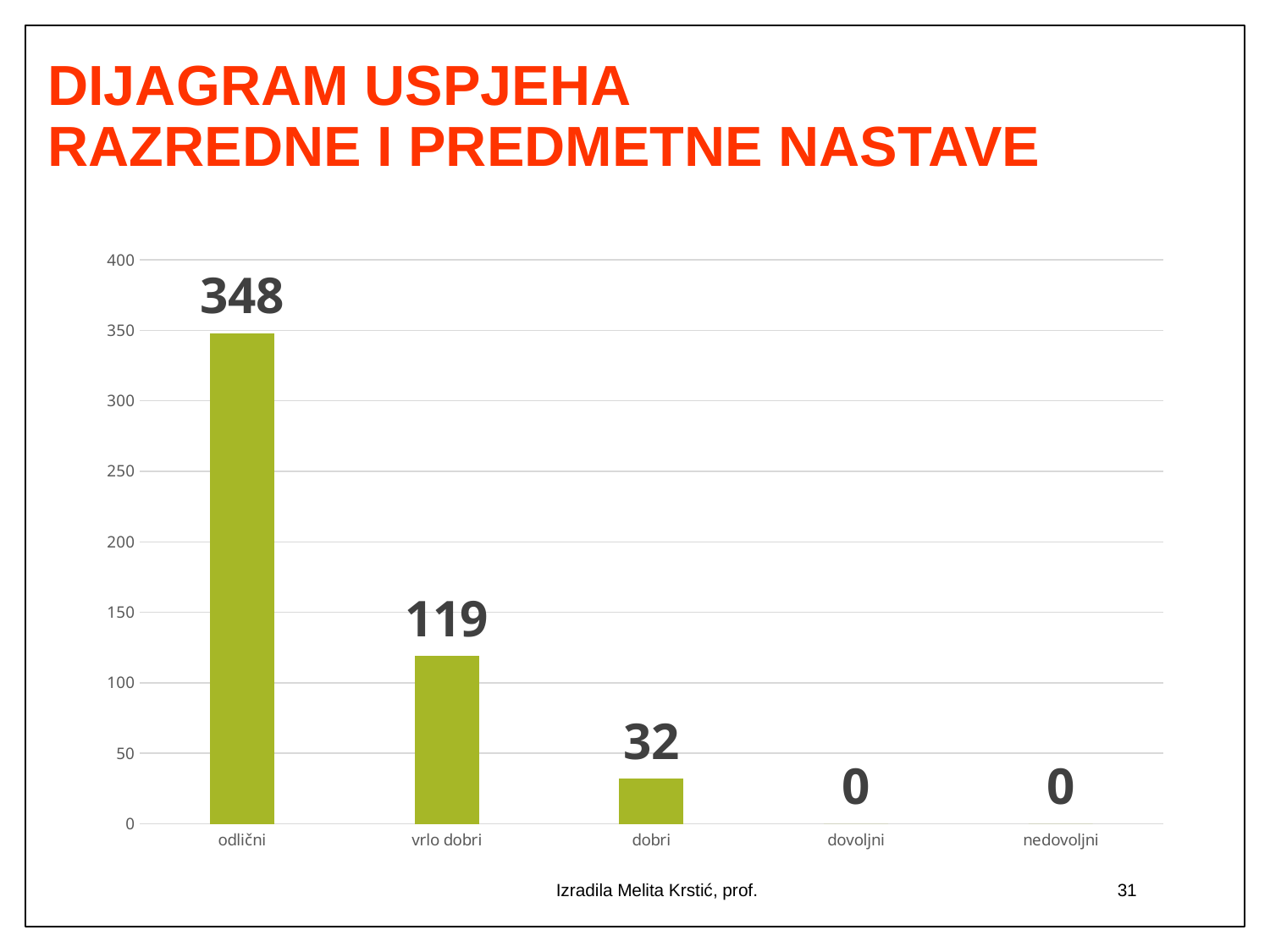
Do the values rise or fall from left to right along the x axis? fall What is the value for vrlo dobri? 119 Is the value for odlični greater or less than 300? greater What is the value for dobri? 32 What is the difference between the values for vrlo dobri and dobri? 87 Which is larger, the value for vrlo dobri or the value for dobri? vrlo dobri What is the value for dovoljni? 0 Which category has the highest value? odlični What is the difference between the values for odlični and vrlo dobri? 229 How many categories are shown on the x axis? 5 What kind of chart is shown on the slide? bar chart What is the value for odlični? 348